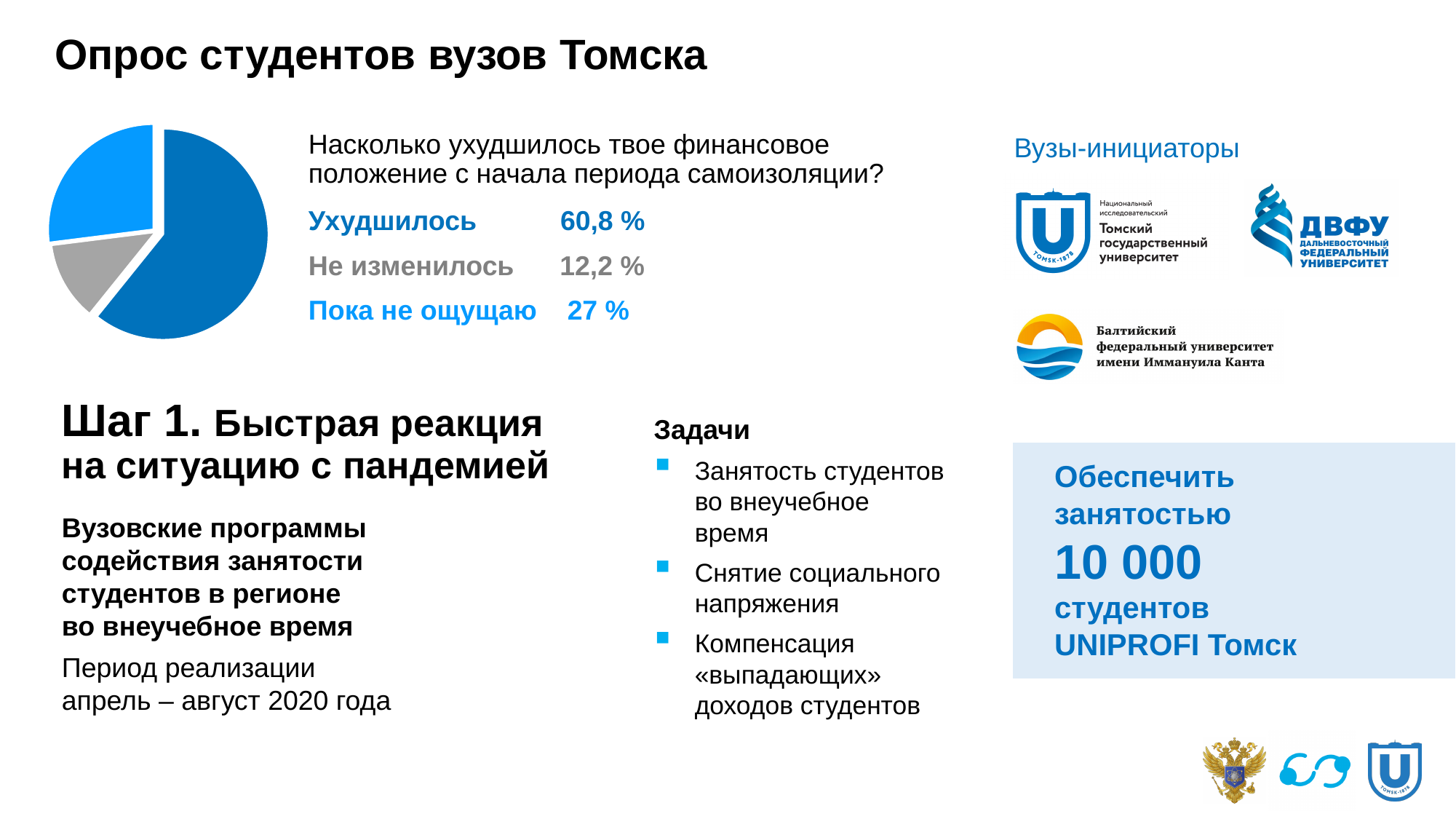
What is the difference in percentage points between "Пока не ощущаю" and "Не изменилось"? 14,8 % What share of students answered "Не изменилось"? 12,2 % What kind of chart is shown on the slide? pie chart What colour is the slice for "Не изменилось" in the pie chart? grey What question does the pie chart summarise the answers to? Насколько ухудшилось твое финансовое положение с начала периода самоизоляции? Which answer has the largest share in the pie chart? Ухудшилось Which answer has the smallest share in the pie chart? Не изменилось What share of students answered "Ухудшилось"? 60,8 % How many slices does the pie chart have? 3 What is the difference in percentage points between "Ухудшилось" and "Пока не ощущаю"? 33,8 % Which is larger: the share for "Пока не ощущаю" or the share for "Не изменилось"? Пока не ощущаю What share of students answered "Пока не ощущаю"? 27 %